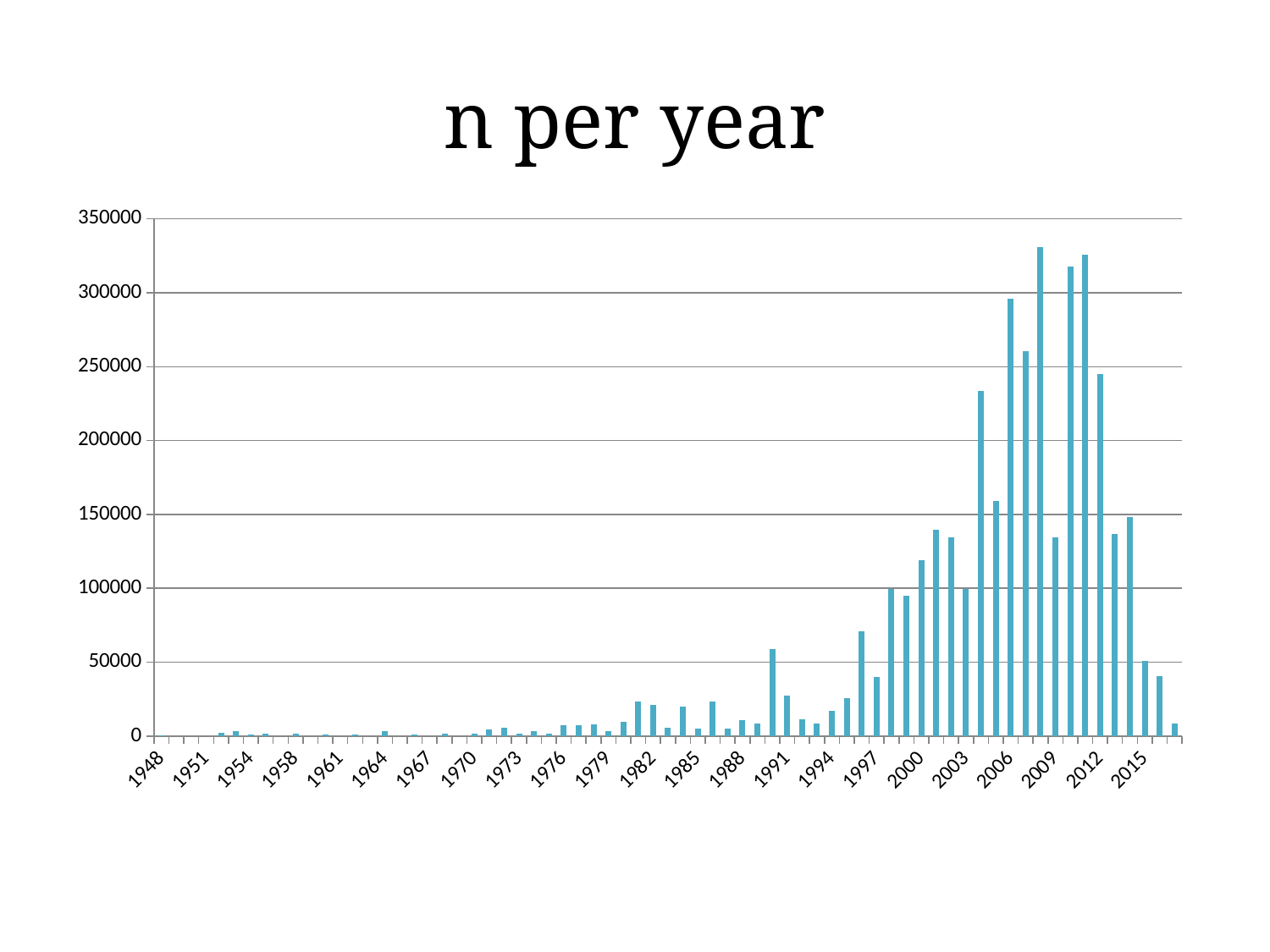
Which year has the larger value, 2009 or 2015? 2009 Is the value for 1997 greater or less than 100000? less What kind of chart is shown on the slide? bar chart What is the title of the chart? n per year What is the highest value shown on the vertical axis? 350000 Is the value for 2012 greater or less than 300000? less Do the values generally rise or fall from 1948 to 2009? rise Is the value for 2015 greater or less than 100000? less Which year has the tallest bar in the chart? 2008